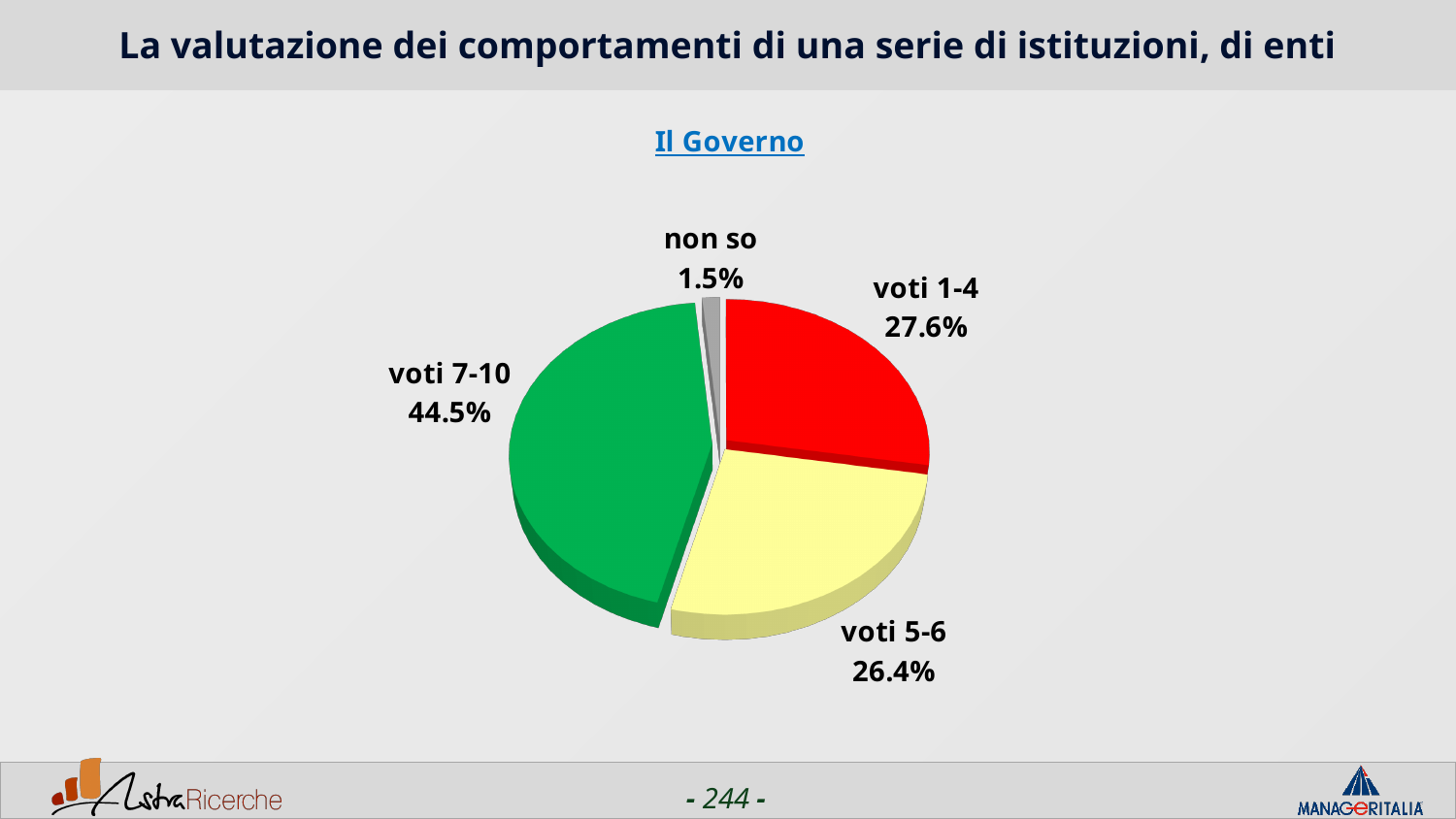
Which is larger, the value for 'voti 7-10' or the value for 'voti 5-6'? voti 7-10 What is the difference between the values for 'voti 1-4' and 'voti 5-6'? 1.2% What kind of chart is shown on the slide? pie chart Which category has the smallest slice of the pie? non so What is the value shown for 'voti 5-6'? 26.4% What is the value shown for 'non so'? 1.5% What share of the pie does 'voti 7-10' hold? 44.5% How many categories are shown in the pie chart? 4 What is the title of the chart? Il Governo What is the difference between the values for 'voti 7-10' and 'voti 1-4'? 16.9% Which category has the largest slice of the pie? voti 7-10 What is the value shown for 'voti 1-4'? 27.6%